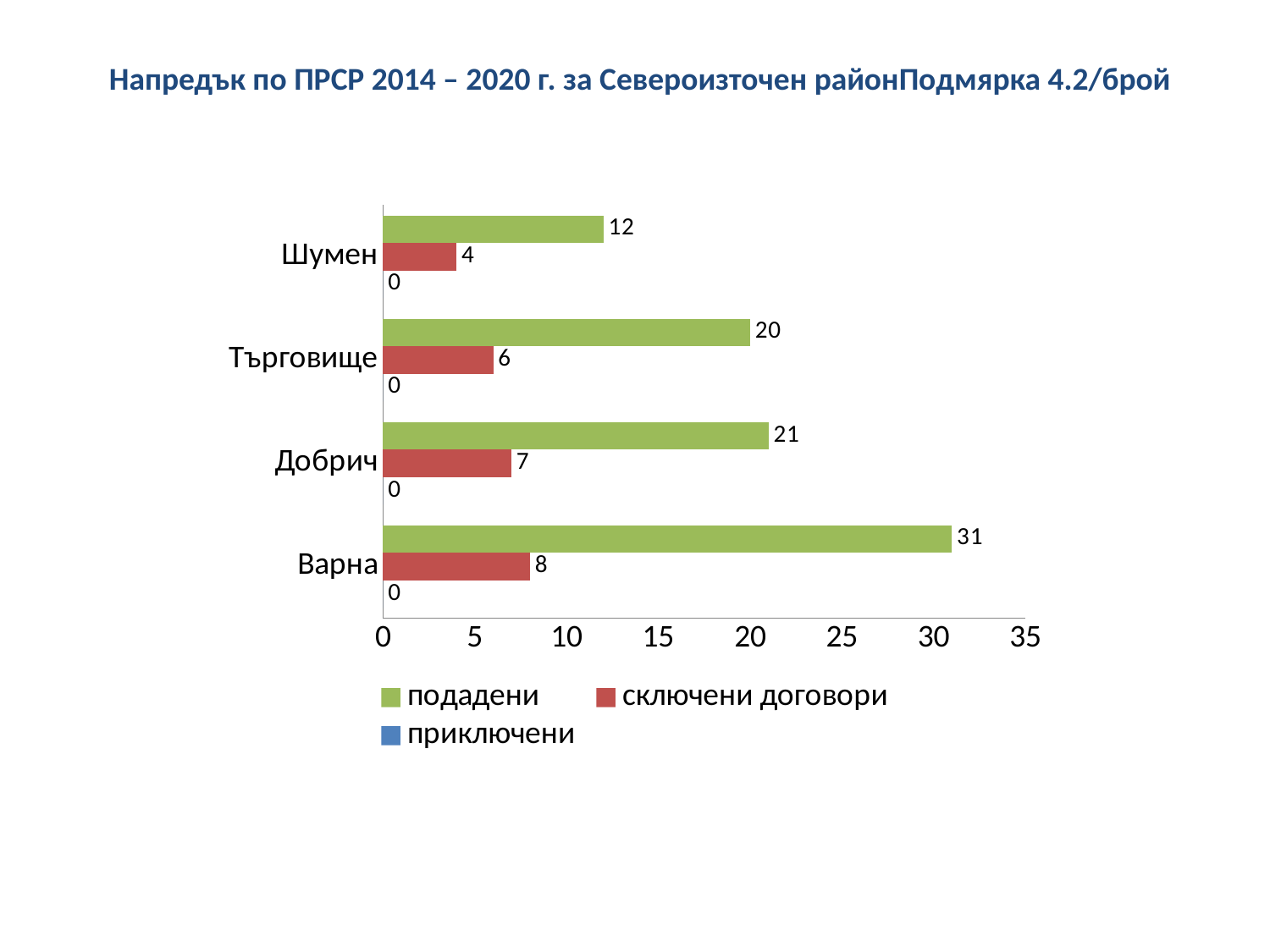
Which is larger: подадени for Търговище or подадени for Шумен? Търговище What is the value of подадени for Варна? 31 How many categories are shown on the chart? 4 What kind of chart is shown on the slide? bar chart What is the value of приключени for Добрич? 0 Which category has the lowest value for сключени договори? Шумен What is the difference between подадени and сключени договори for Добрич? 14 What colour are the bars for сключени договори? red Is the value of подадени for Варна greater or less than 30? greater How many series does the legend list? 3 What is the value of сключени договори for Търговище? 6 Which category has the highest value for подадени? Варна